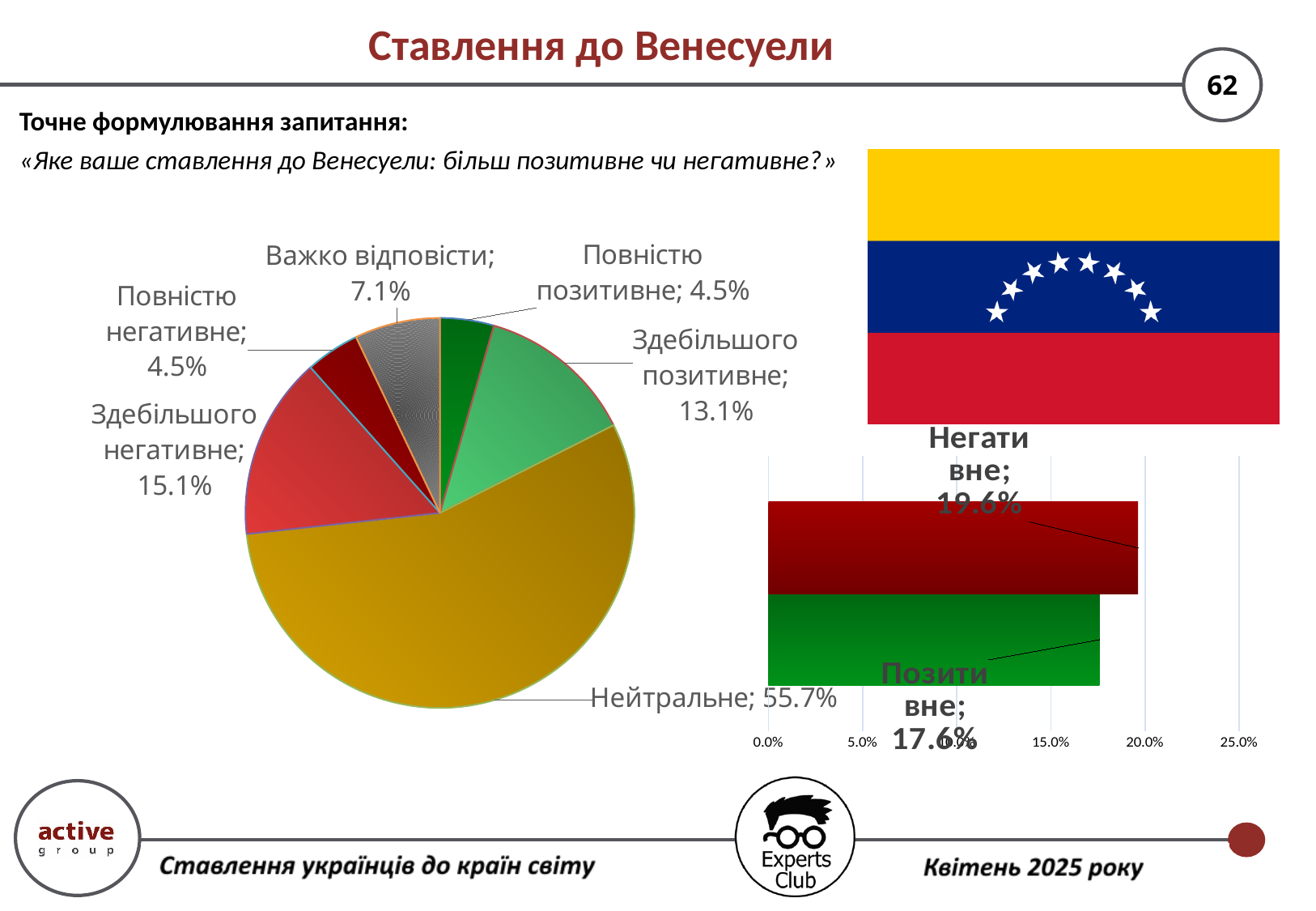
In the bar chart on the right, what is the value for "Позитивне"? 17.6% In the pie chart, what share of respondents answered "Нейтральне"? 55.7% In the pie chart, which is larger: "Здебільшого негативне" or "Здебільшого позитивне"? Здебільшого негативне In the pie chart, what is the difference between "Здебільшого негативне" and "Здебільшого позитивне"? 2.0% In the pie chart, what is the value for "Здебільшого негативне"? 15.1% In the pie chart, how many slices (categories) are there? 6 In the bar chart on the right, what is the value for "Негативне"? 19.6% In the pie chart, what is the value for "Важко відповісти"? 7.1% What type of chart is shown on the right side of the slide? Bar chart In the pie chart, which category has the largest share? Нейтральне In the pie chart, what is the value for "Здебільшого позитивне"? 13.1% In the bar chart on the right, what is the difference between "Негативне" and "Позитивне"? 2.0%